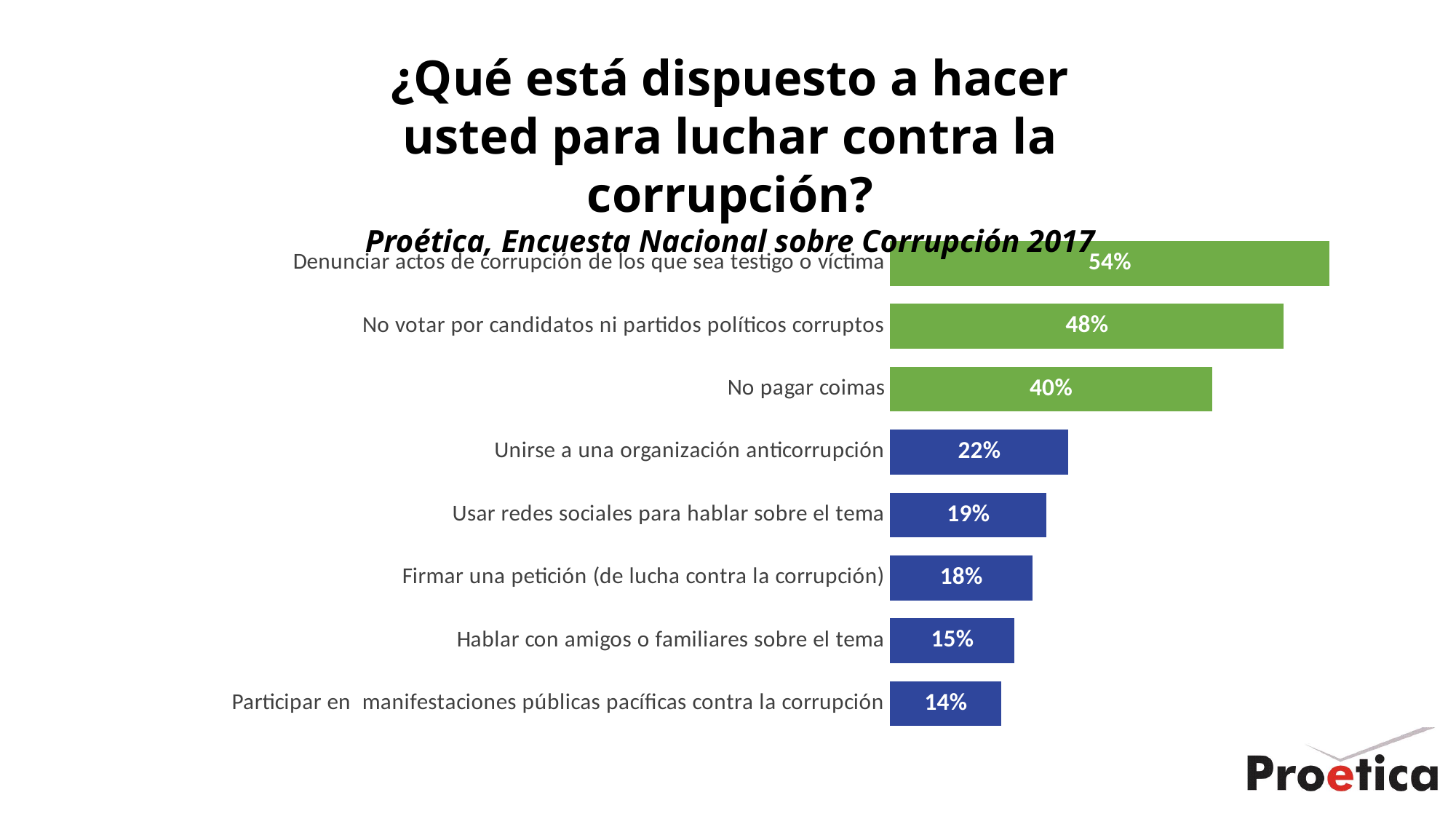
Which is larger: 'Firmar una petición (de lucha contra la corrupción)' or 'Hablar con amigos o familiares sobre el tema'? Firmar una petición (de lucha contra la corrupción) What is the value for 'No pagar coimas'? 40% What source is cited in the chart subtitle? Proética, Encuesta Nacional sobre Corrupción 2017 What kind of chart is shown on the slide? Bar chart How many actions (categories) are shown in the chart? 8 Which action has the highest percentage? Denunciar actos de corrupción de los que sea testigo o víctima What is the difference between the highest and lowest values in the chart? 40% What percentage of respondents are willing to report acts of corruption they witness or are victims of (Denunciar actos de corrupción de los que sea testigo o víctima)? 54% What is the difference between 'No votar por candidatos ni partidos políticos corruptos' and 'Unirse a una organización anticorrupción'? 26% Which action has the lowest percentage? Participar en manifestaciones públicas pacíficas contra la corrupción What is the value for 'Usar redes sociales para hablar sobre el tema'? 19% How many bars are coloured green? 3